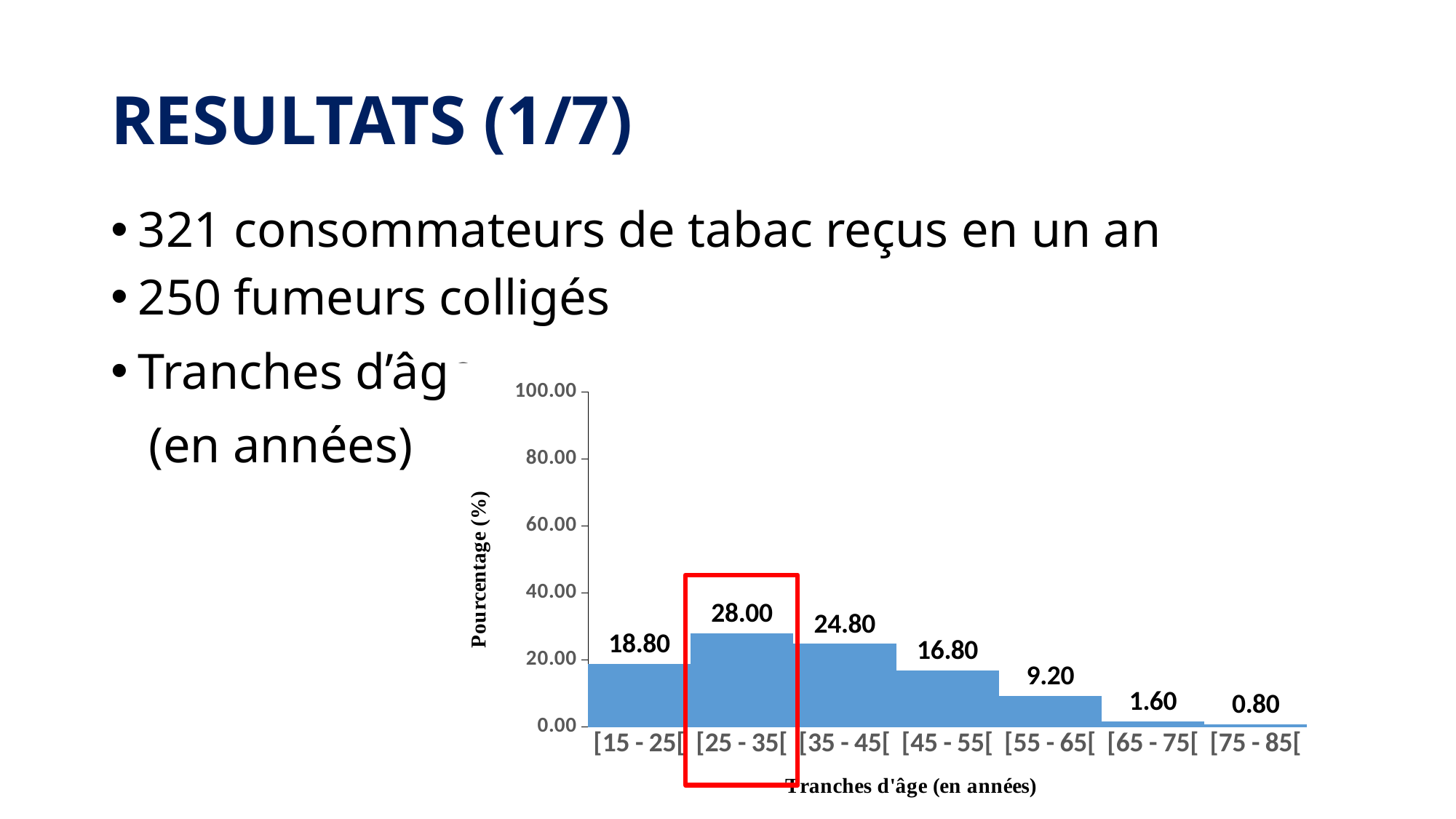
Which has a larger percentage, [15 - 25[ or [45 - 55[? [15 - 25[ What is the difference between the percentages for [25 - 35[ and [35 - 45[? 3.20 What is the percentage for the [75 - 85[ age group? 0.80 What is the label of the y axis? Pourcentage (%) What kind of chart is shown on the slide? bar chart Is the value for [35 - 45[ greater or less than 20.00? greater Which age group has the lowest percentage? [75 - 85[ From [25 - 35[ to [75 - 85[, do the values rise or fall along the x axis? fall How many age groups are shown on the x axis? 7 What is the percentage for the [55 - 65[ age group? 9.20 Which age group has the highest percentage? [25 - 35[ What is the percentage for the [25 - 35[ age group? 28.00